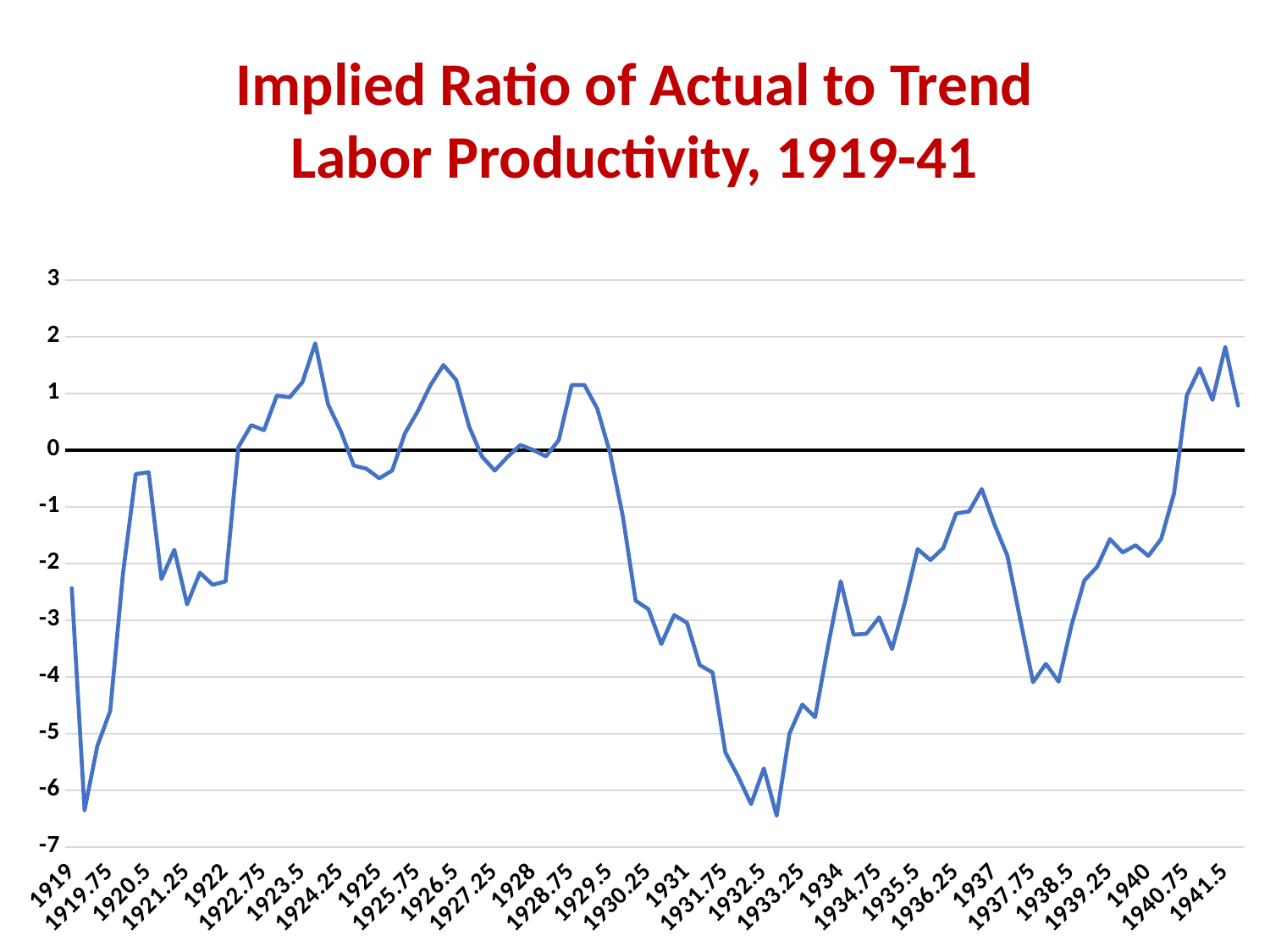
What is the title of the chart? Implied Ratio of Actual to Trend Labor Productivity, 1919-41 Is the value for 1923.5 greater or less than 1? greater How many data series are plotted on the chart? 1 Is the value for 1926.5 greater or less than 1? greater Do the values rise or fall between 1929.5 and 1932.5? fall What is the lowest value shown on the vertical axis? -7 Is the value for 1937 greater or less than -1? less Which is larger, the value for 1934 or the value for 1937? 1937 What kind of chart is shown on the slide? line chart